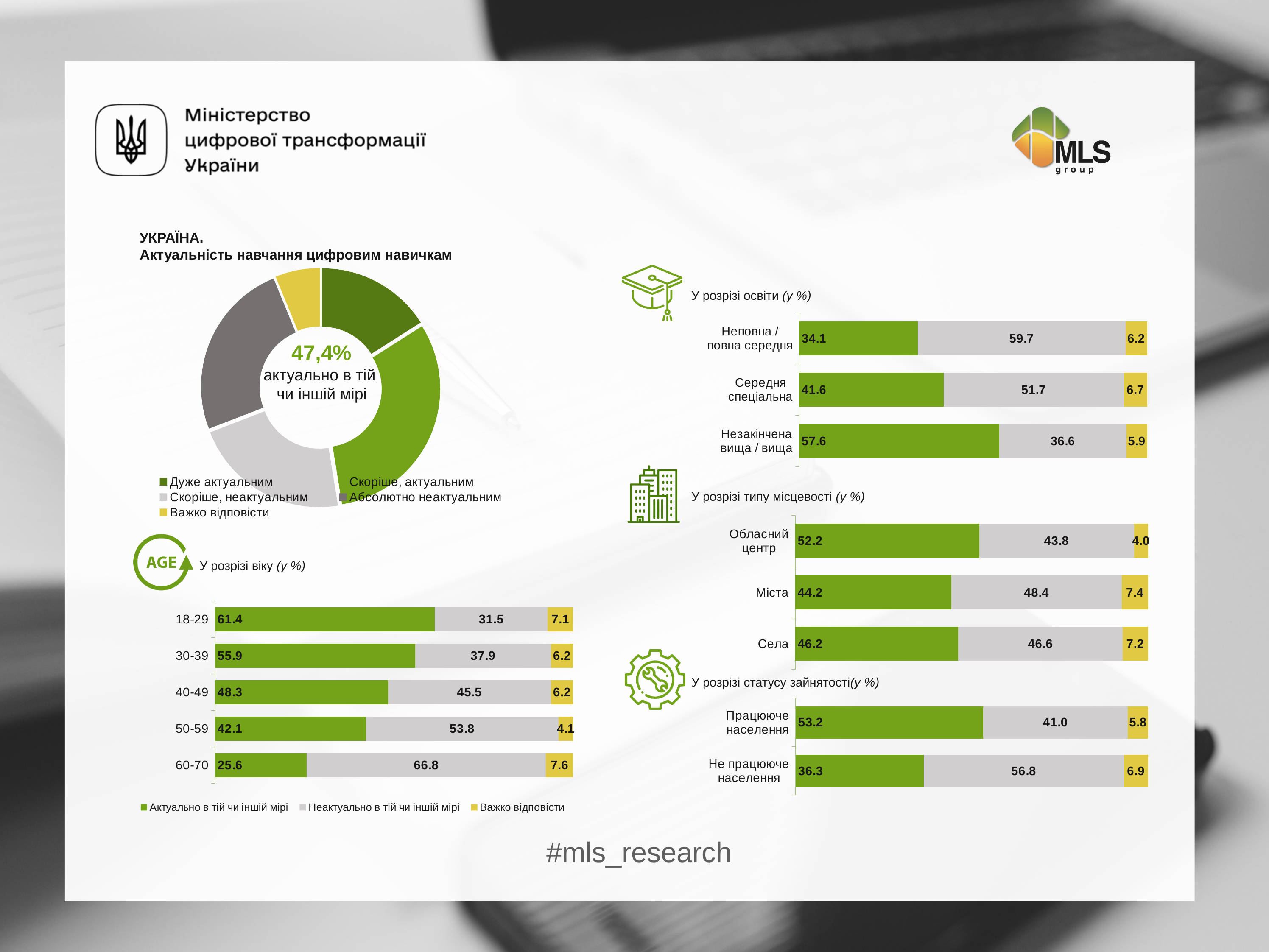
In the chart 'У розрізі типу місцевості (у %)', what is the 'Важко відповісти' value for 'Обласний центр'? 4.0 In the chart 'У розрізі віку (у %)', how many age groups are shown? 5 What kind of chart is the chart titled 'УКРАЇНА. Актуальність навчання цифровим навичкам'? Donut (pie) chart In the chart 'У розрізі віку (у %)', what is the value of 'Актуально в тій чи іншій мірі' for the 18-29 age group? 61.4 In the chart 'У розрізі освіти (у %)', what is the 'Неактуально в тій чи іншій мірі' value for 'Середня спеціальна'? 51.7 In the chart 'У розрізі віку (у %)', does the 'Актуально в тій чи іншій мірі' value rise or fall as the age groups get older? fall In the chart 'У розрізі віку (у %)', which age group has the highest value for 'Неактуально в тій чи іншій мірі'? 60-70 In the chart 'У розрізі статусу зайнятості (у %)', what is the difference between the 'Актуально в тій чи іншій мірі' values for 'Працююче населення' and 'Не працююче населення'? 16.9 In the chart 'У розрізі віку (у %)', which age group has the lowest value for 'Актуально в тій чи іншій мірі'? 60-70 In the chart 'У розрізі типу місцевості (у %)', which is larger: the 'Актуально в тій чи іншій мірі' value for 'Міста' or for 'Села'? Села In the chart 'У розрізі освіти (у %)', which education group has the highest 'Актуально в тій чи іншій мірі' value? Незакінчена вища / вища In the chart 'У розрізі віку (у %)', what is the difference between the 'Актуально в тій чи іншій мірі' values for 18-29 and 30-39? 5.5